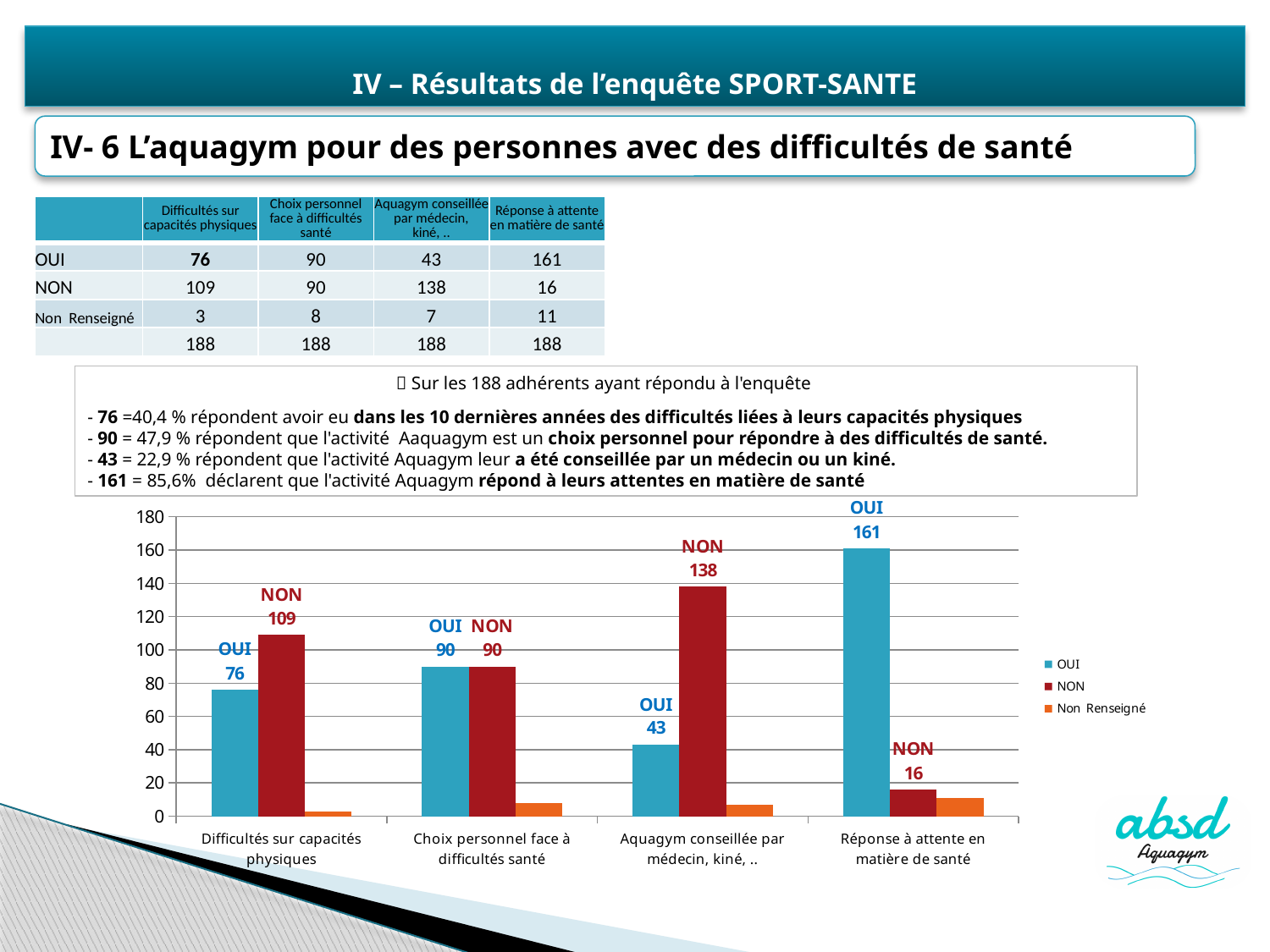
How many series does the chart legend list? 3 Which series is shown in red in the chart? NON For 'Aquagym conseillée par médecin, kiné, ..', which is larger, OUI or NON? NON What is the OUI value for 'Réponse à attente en matière de santé'? 161 How many categories are shown on the x axis of the chart? 4 Which category has the lowest NON value? Réponse à attente en matière de santé What is the OUI value for 'Difficultés sur capacités physiques'? 76 What kind of chart is shown on the slide? bar chart What is the NON value for 'Aquagym conseillée par médecin, kiné, ..'? 138 What is the difference between the NON and OUI values for 'Difficultés sur capacités physiques'? 33 Which category has the highest OUI value? Réponse à attente en matière de santé Is the Non Renseigné value for 'Réponse à attente en matière de santé' greater or less than 20? less